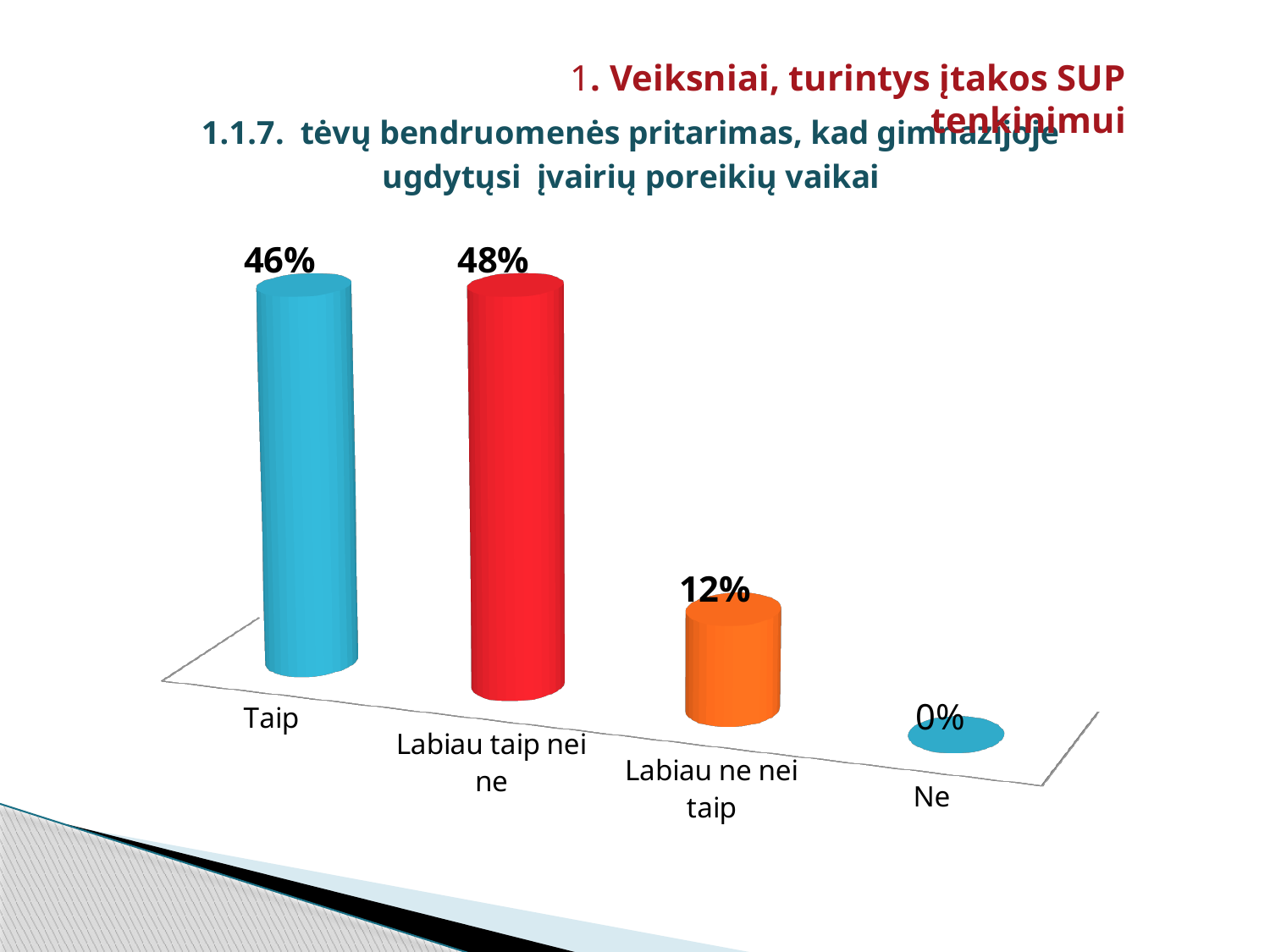
Which category has the lowest value? Ne How many categories are shown in the chart? 4 What colour is the bar for "Labiau taip nei ne"? Red Which is larger, the value for "Taip" or the value for "Labiau ne nei taip"? Taip What is the difference between the values for "Labiau taip nei ne" and "Taip"? 2% Which category has the highest value? Labiau taip nei ne What is the value for "Labiau ne nei taip"? 12% What is the value for "Taip"? 46% What is the difference between the values for "Taip" and "Labiau ne nei taip"? 34% What is the value for "Ne"? 0% What is the value for "Labiau taip nei ne"? 48% What kind of chart is shown on the slide? Bar chart